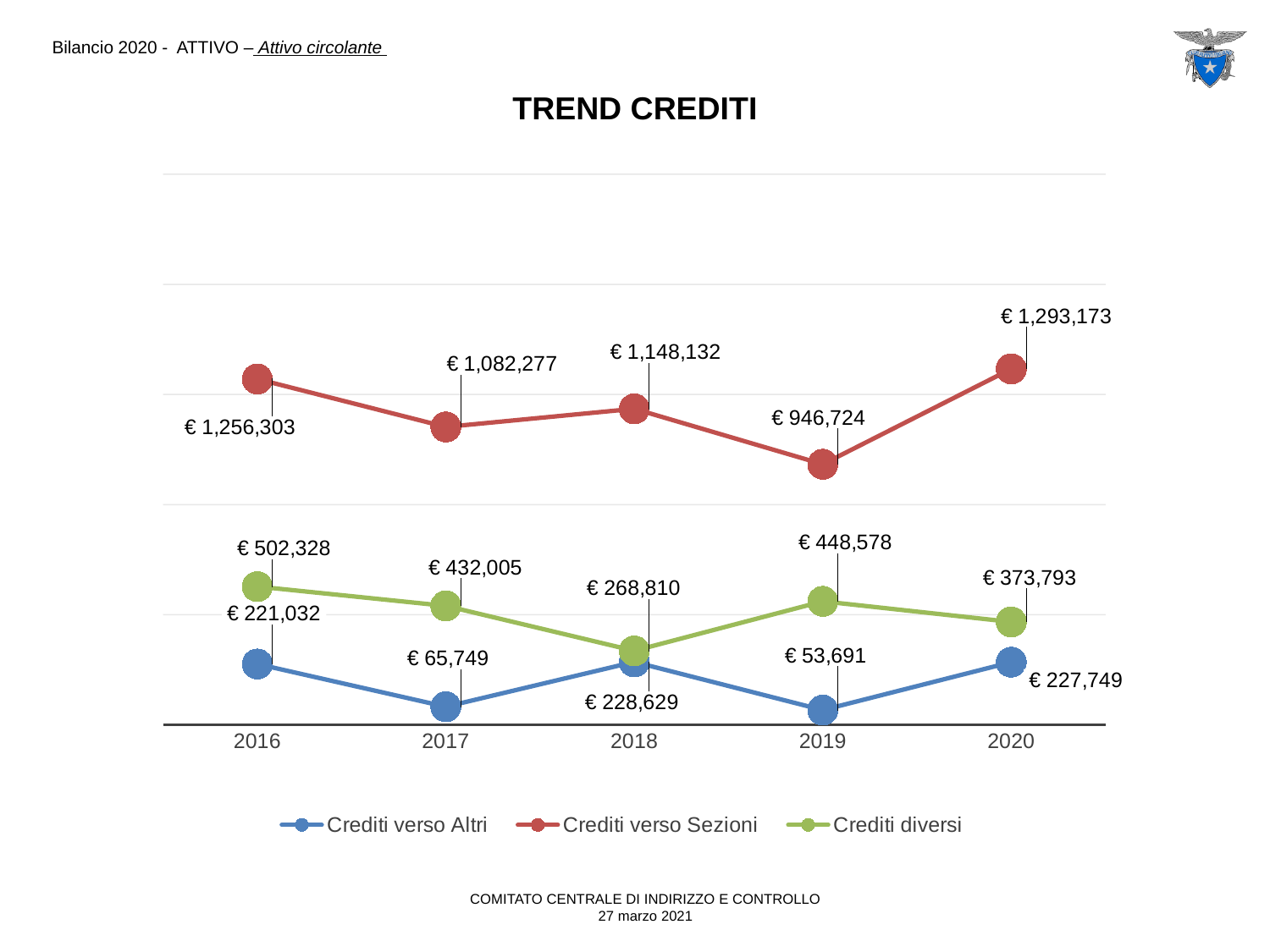
What is the difference between Crediti verso Altri in 2018 and in 2017? € 162,880 In which year is Crediti diversi highest? 2016 Which is larger in 2019: Crediti diversi or Crediti verso Altri? Crediti diversi How many series does the legend list? 3 What is the difference between Crediti verso Sezioni in 2020 and in 2019? € 346,449 How many years are shown on the x axis? 5 What is the value of Crediti verso Altri in 2017? € 65,749 In which year is Crediti verso Altri lowest? 2019 What is the value of Crediti verso Sezioni in 2019? € 946,724 In which year is Crediti verso Sezioni highest? 2020 What kind of chart is shown on the slide? Line chart What is the value of Crediti diversi in 2018? € 268,810